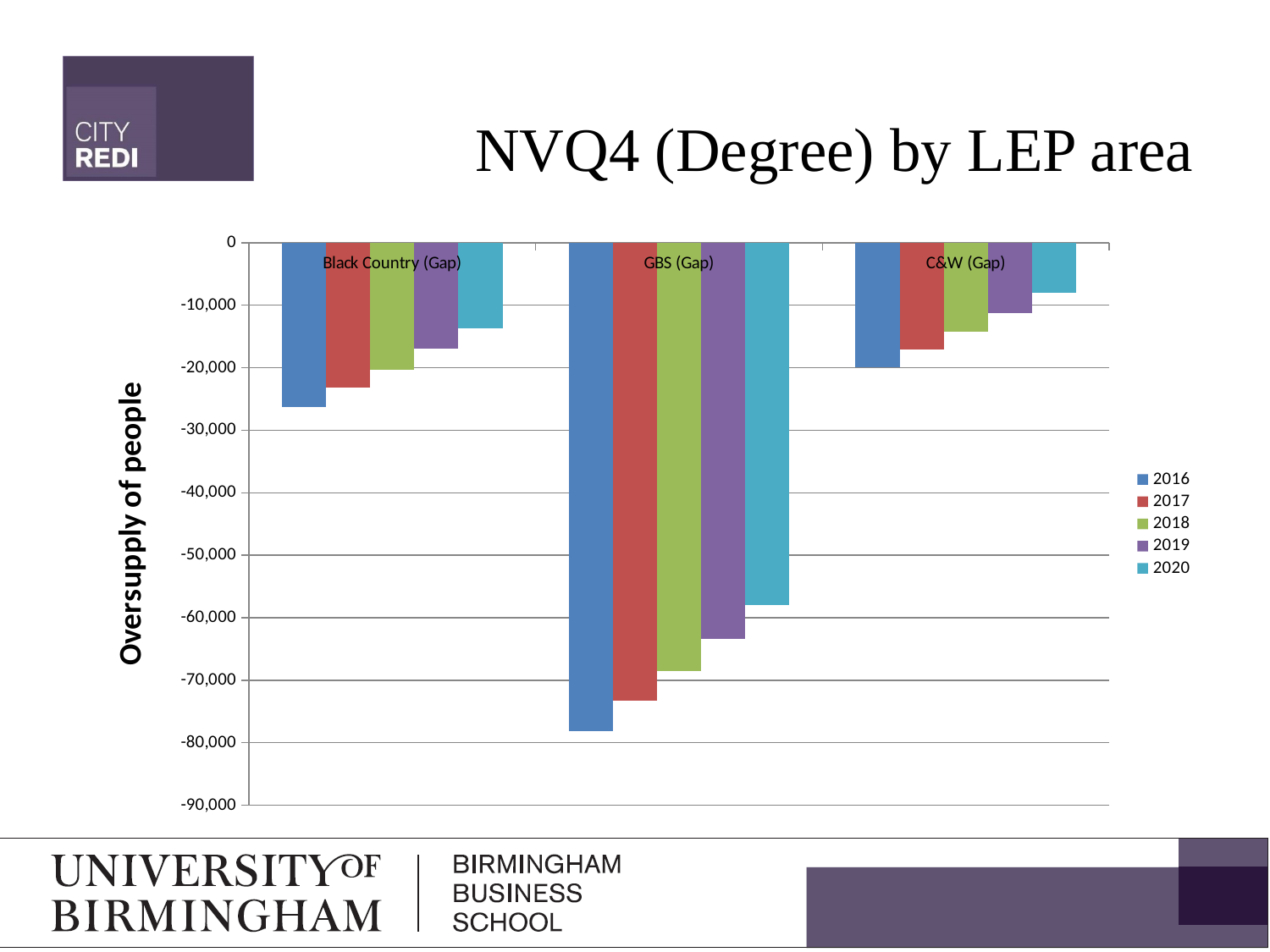
How many series does the legend list? 5 What kind of chart is shown on the slide? bar chart Which is further from zero: the 2016 value for Black Country (Gap) or the 2016 value for C&W (Gap)? Black Country (Gap) What is the label of the vertical axis? Oversupply of people What is the title of the chart? NVQ4 (Degree) by LEP area Which LEP area has the longest bars (the largest negative values)? GBS (Gap) Which LEP area has the shortest bars (values closest to zero)? C&W (Gap) Which single bar has the lowest (most negative) value on the chart? GBS (Gap), 2016 Within GBS (Gap), do the bars get longer or shorter from 2016 to 2020? shorter How many LEP area categories are shown on the x axis? 3 Is the value for Black Country (Gap) in 2020 greater or less than -20,000? greater Is the value for GBS (Gap) in 2016 greater or less than -70,000? less